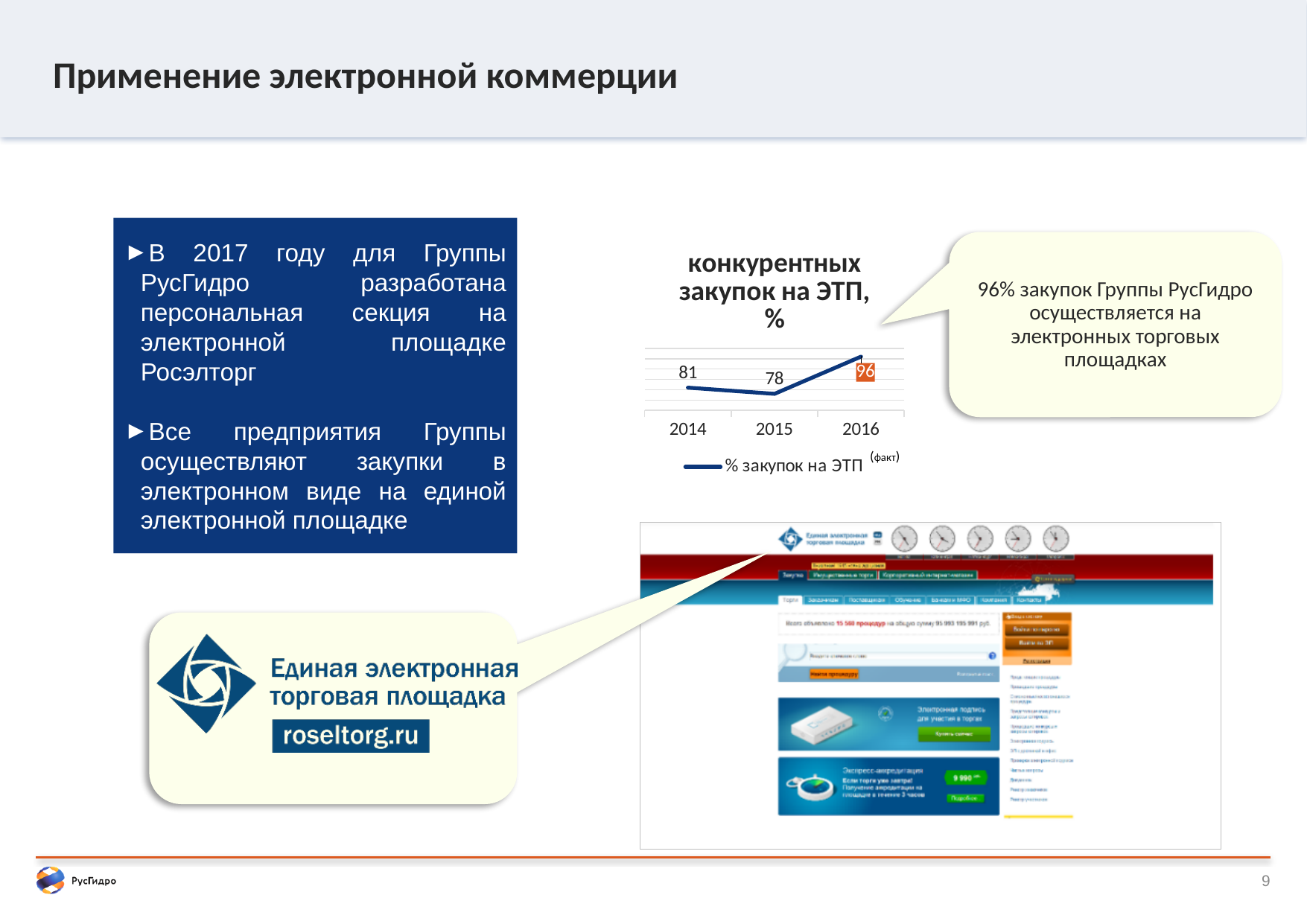
Which is larger on the line chart, the value for 2014 or the value for 2015? 2014 What is the value for 2016 on the line chart? 96 How many series does the legend of the line chart list? 1 What kind of chart is shown on the slide? line chart Which year has the highest value on the line chart? 2016 What is the value for 2015 on the line chart? 78 What is the difference between the 2014 and 2015 values on the line chart? 3 What is the difference between the 2016 and 2015 values on the line chart? 18 Which year has the lowest value on the line chart? 2015 What is the legend entry of the line chart? % закупок на ЭТП (факт) What is the value for 2014 on the line chart? 81 How many years are plotted on the line chart? 3